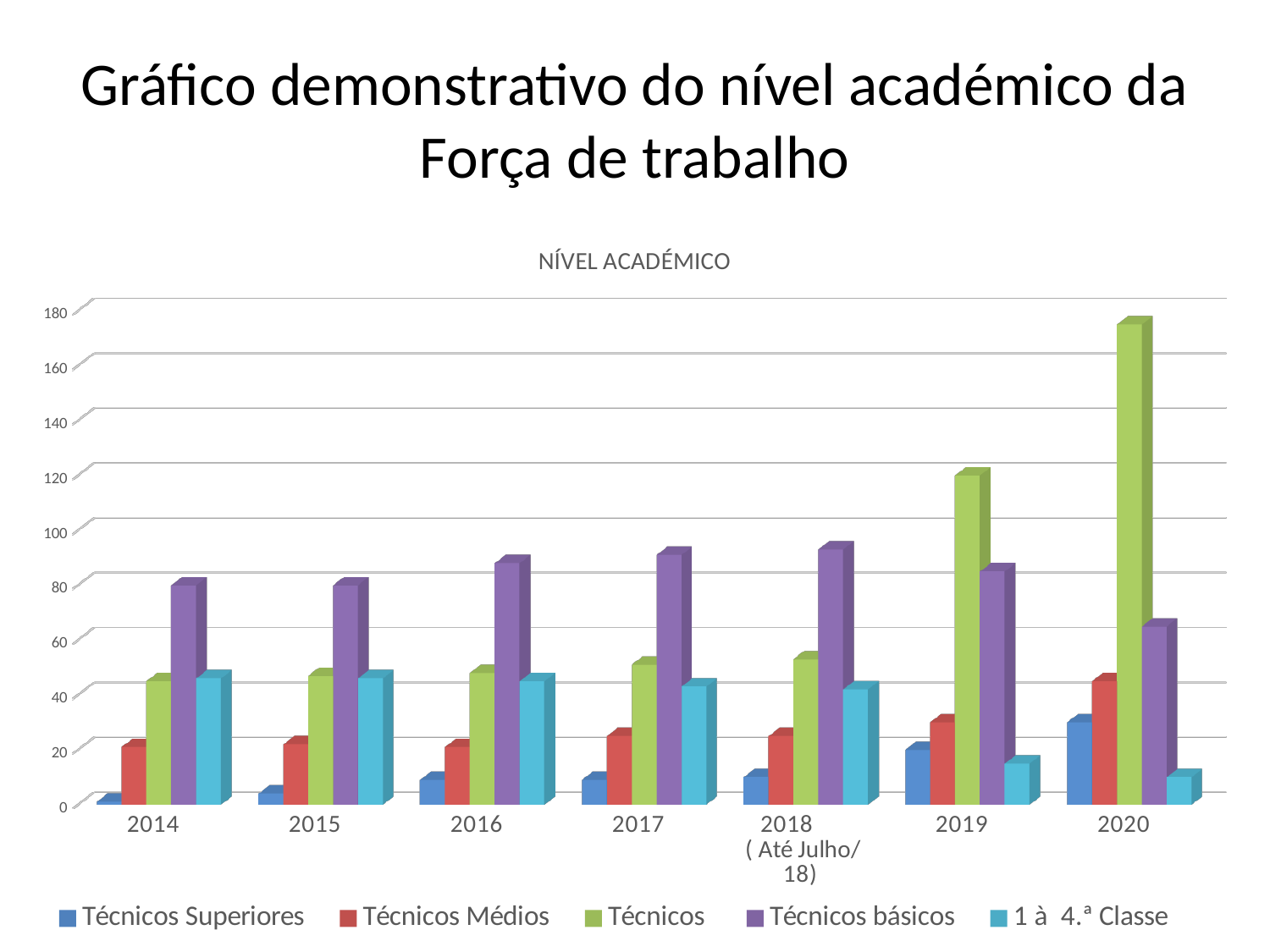
What kind of chart is shown on the slide? bar chart How many year categories are shown on the x axis? 7 In which year is the value for Técnicos the highest? 2020 In 2014, which is larger: Técnicos básicos or Técnicos? Técnicos básicos How many series does the legend list? 5 In 2020, which is larger: Técnicos or Técnicos básicos? Técnicos Is the value for Técnicos in 2020 greater or less than 160? greater What is the title of the chart? NÍVEL ACADÉMICO Which series has the lowest value in 2014? Técnicos Superiores Do the values for Técnicos Superiores rise or fall from 2014 to 2020? rise Is the value for 1 à 4.ª Classe in 2020 greater or less than 20? less Is the value for Técnicos básicos in 2014 greater or less than 100? less